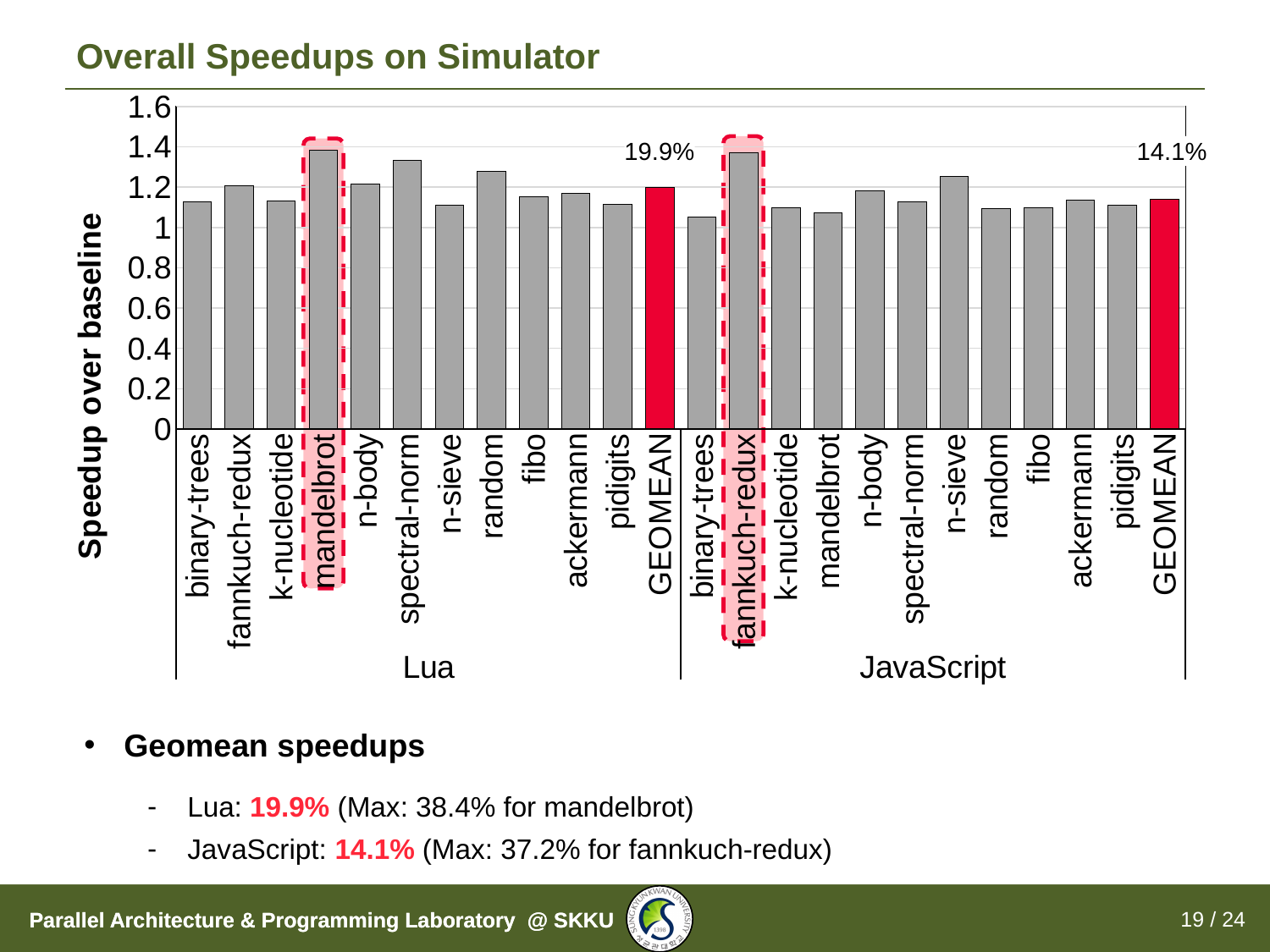
Which benchmark has the highest speedup in the Lua group? mandelbrot What is the difference between the Lua geomean speedup label (19.9%) and the JavaScript geomean speedup label (14.1%)? 5.8 percentage points What percentage label is printed above the GEOMEAN bar in the Lua group? 19.9% What is the title of the y-axis? Speedup over baseline What kind of chart is shown on the slide? Bar chart Is the speedup for n-sieve in the JavaScript group greater or less than 1.2? greater What percentage label is printed above the GEOMEAN bar in the JavaScript group? 14.1% How many bars are plotted in the Lua group, including GEOMEAN? 12 Is the speedup for binary-trees in the JavaScript group greater or less than 1.2? less Which benchmark has the highest speedup in the JavaScript group? fannkuch-redux Is the speedup for mandelbrot in the Lua group greater or less than 1.2? greater In the Lua group, which has the larger speedup: spectral-norm or n-sieve? spectral-norm